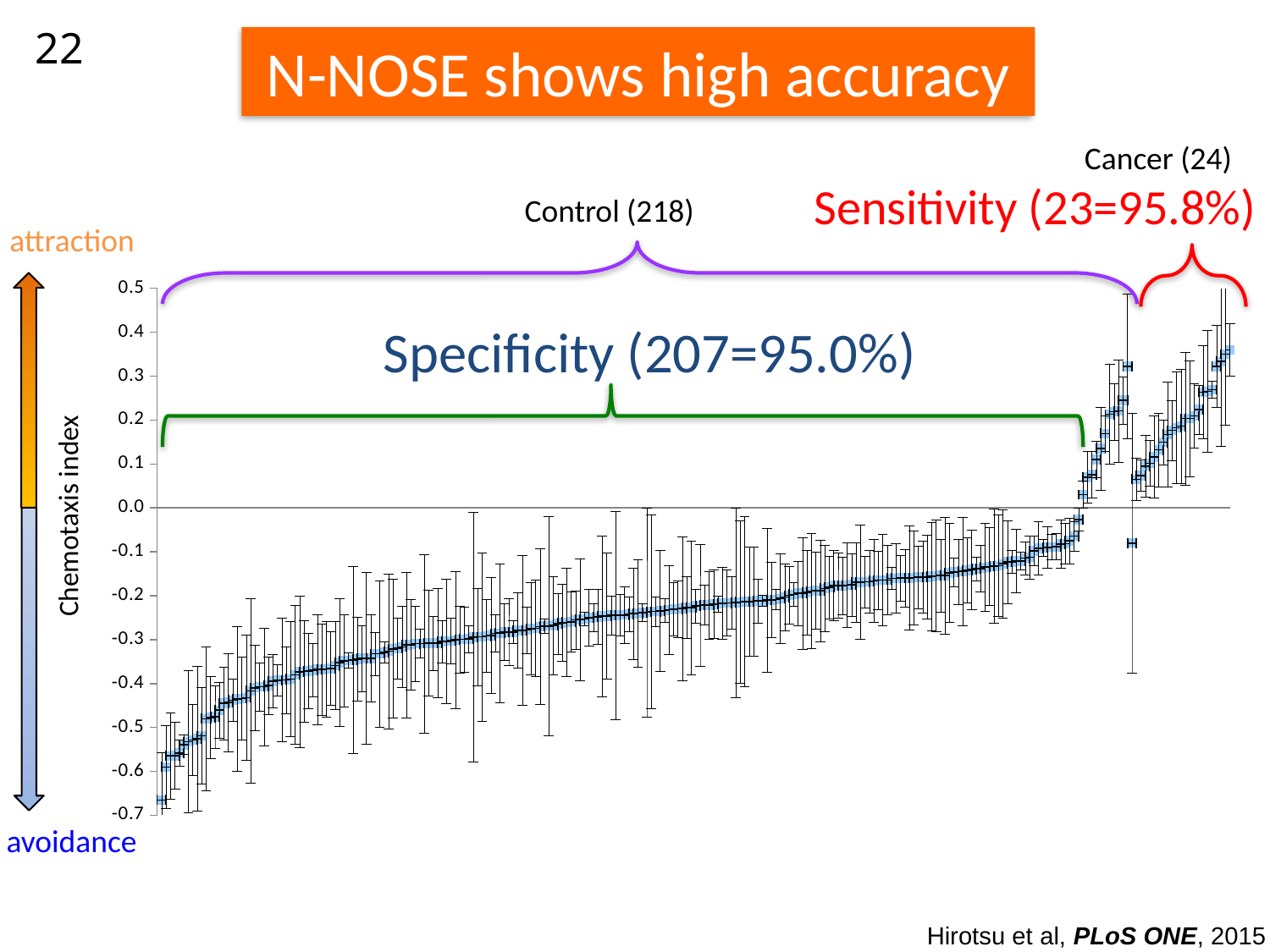
What is the title of the slide containing the chart? N-NOSE shows high accuracy What specificity is reported on the chart for the control group? 207=95.0% What is the lowest tick value shown on the y axis of the chart? -0.7 What sensitivity is reported on the chart for the cancer group? 23=95.8% What is the highest tick value shown on the y axis of the chart? 0.5 How many control samples are plotted in the chart? 218 Is the chemotaxis index of the leftmost control sample greater or less than -0.6? less Which group, control or cancer, has the higher chemotaxis index values overall in the chart? Cancer Do the chemotaxis index values of the control samples rise or fall from left to right along the x axis? rise Is the chemotaxis index of the rightmost cancer sample greater or less than 0.3? greater How many cancer samples are plotted in the chart? 24 What is the label of the y axis of the chart? Chemotaxis index